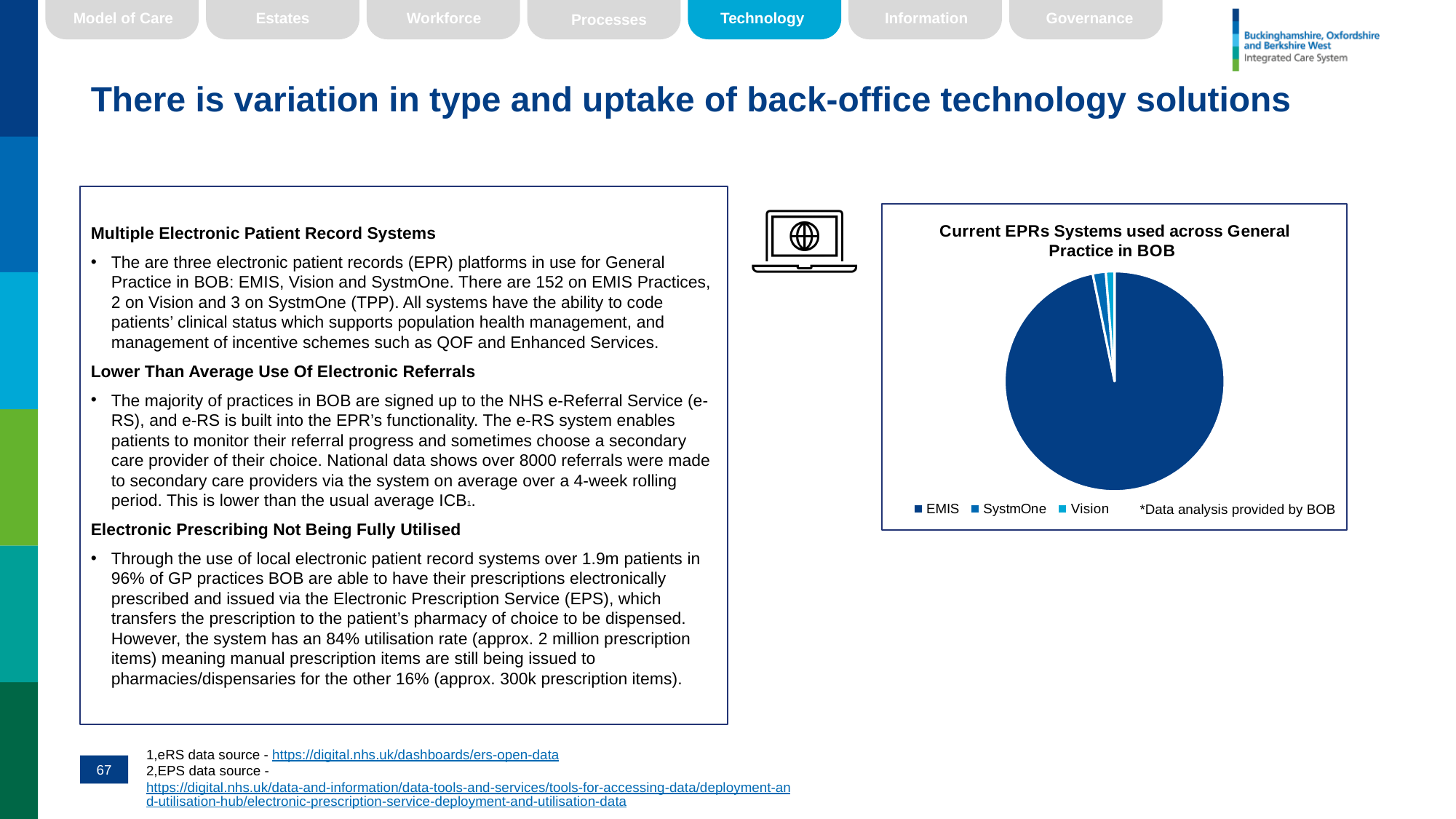
How many slices does the pie chart have? 3 Which is larger in the pie chart, the EMIS slice or the Vision slice? EMIS Which is larger in the pie chart, the SystmOne slice or the EMIS slice? EMIS Which EPR system has the largest slice in the pie chart? EMIS What type of chart is shown on the slide? Pie chart Does the EMIS slice take up more or less than half of the pie chart? More What is the title of the pie chart? Current EPRs Systems used across General Practice in BOB Which legend entries in the pie chart are shown in the lighter blue colours? SystmOne and Vision How many series does the pie chart's legend list? 3